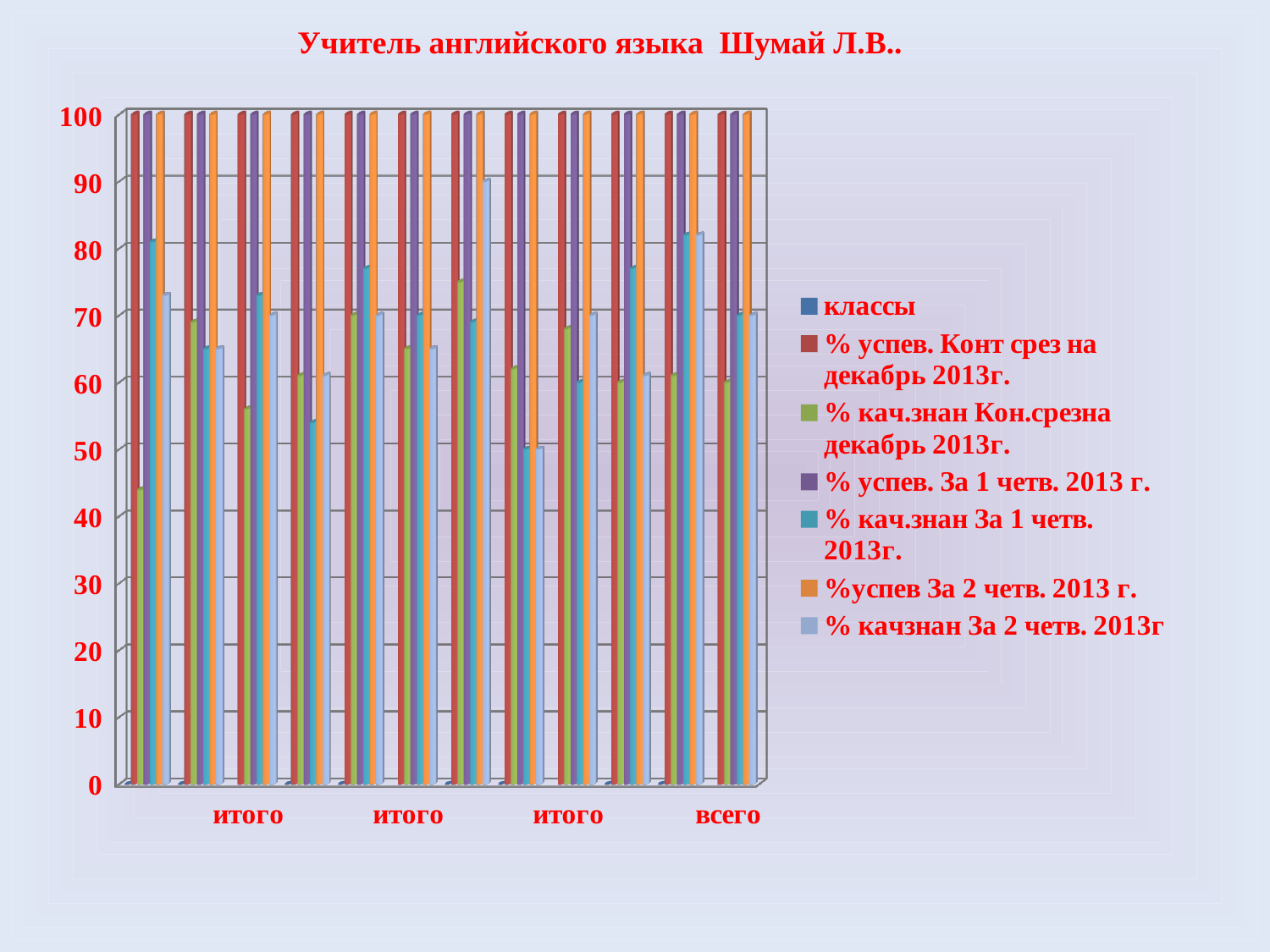
What is the first entry in the chart's legend? классы What is the label of the last category on the x axis? всего Is the value for "%успев За 2 четв. 2013 г." in the "всего" group greater or less than 90? greater What is the title of the slide above the chart? Учитель английского языка Шумай Л.В.. How many groups of bars are plotted in the chart? 12 How many series does the legend list? 7 Is the value for "% кач.знан Кон.срезна декабрь 2013г." in the "всего" group greater or less than 70? less What kind of chart is shown on the slide? bar chart In the "всего" group, which is larger: "% кач.знан За 1 четв. 2013г." or "% кач.знан Кон.срезна декабрь 2013г."? % кач.знан За 1 четв. 2013г.